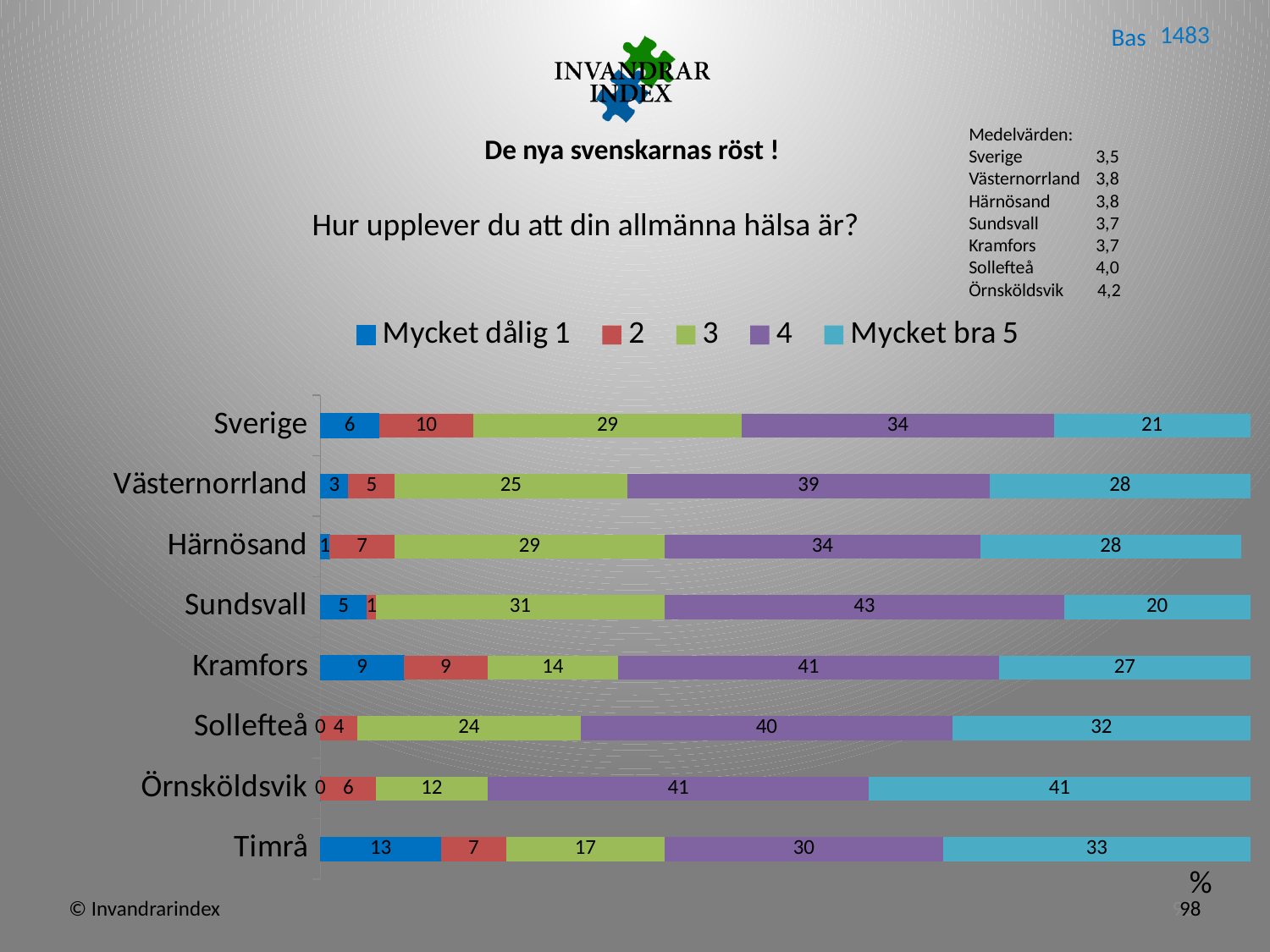
Which is larger: the "Mycket bra 5" value for Sollefteå or for Kramfors? Sollefteå Which category has the highest value for "Mycket bra 5"? Örnsköldsvik What is the value for "3" for Kramfors? 14 What is the value for "Mycket bra 5" for Timrå? 33 What is the difference between the "4" values for Sundsvall and Sverige? 9 What is the value for "4" for Sundsvall? 43 How many series does the legend list? 5 How many categories (regions) are shown on the chart? 8 What is the total of the stacked bar for Härnösand? 99 Which category has the highest value for "Mycket dålig 1"? Timrå What kind of chart is shown on the slide? bar chart What is the first entry in the chart legend? Mycket dålig 1